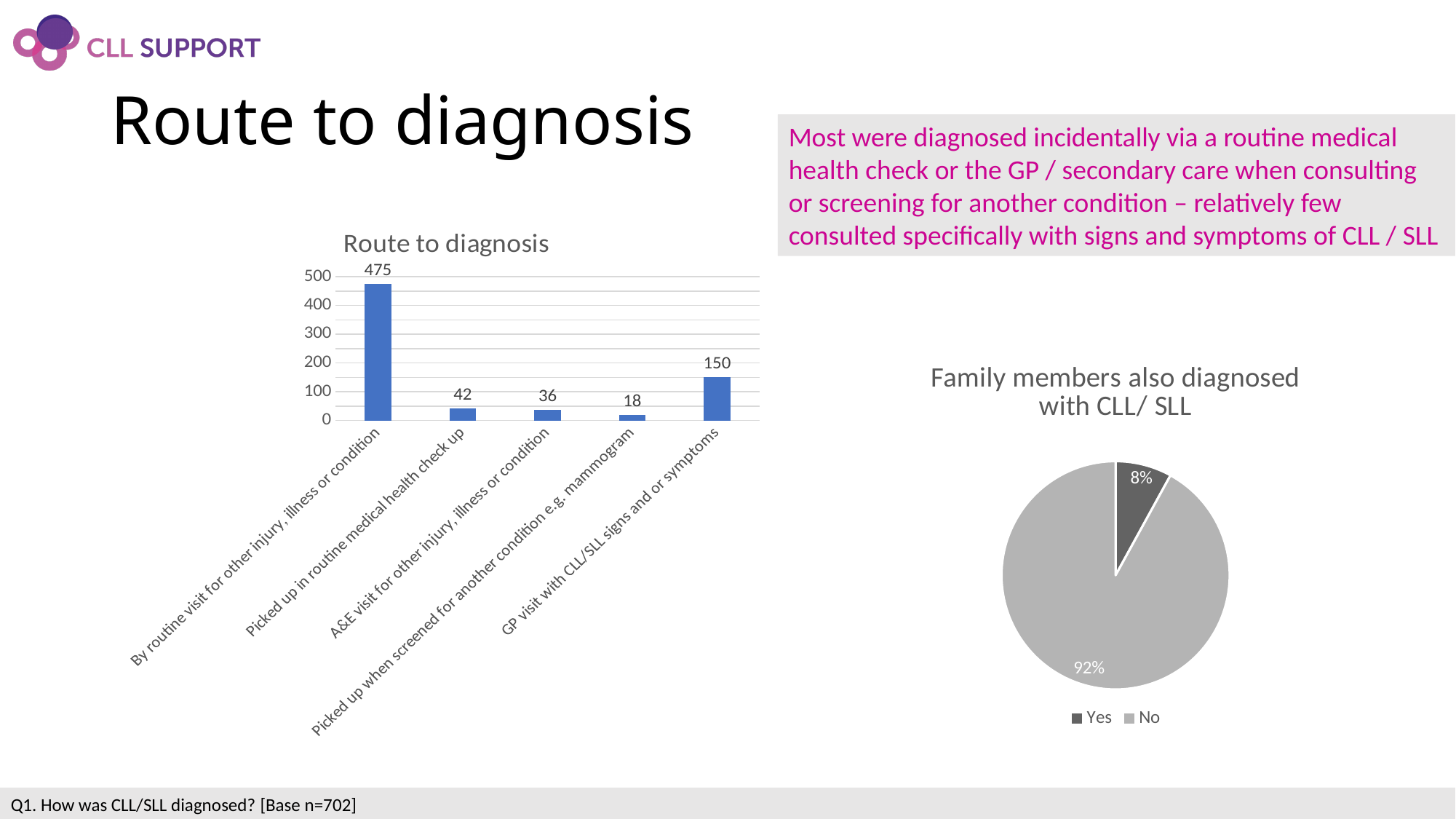
How many entries does the legend of the 'Family members also diagnosed with CLL/ SLL' chart list? 2 What kind of chart is the 'Route to diagnosis' chart? Bar chart In the 'Route to diagnosis' chart, what is the value for 'By routine visit for other injury, illness or condition'? 475 In the 'Route to diagnosis' chart, which category has the highest value? By routine visit for other injury, illness or condition In the 'Family members also diagnosed with CLL/ SLL' chart, what share of the pie is 'No'? 92% In the 'Route to diagnosis' chart, what is the value for 'GP visit with CLL/SLL signs and or symptoms'? 150 In the 'Route to diagnosis' chart, what is the value for 'Picked up when screened for another condition e.g. mammogram'? 18 In the 'Family members also diagnosed with CLL/ SLL' chart, what share of the pie is 'Yes'? 8% In the 'Route to diagnosis' chart, which is larger: 'Picked up in routine medical health check up' or 'A&E visit for other injury, illness or condition'? Picked up in routine medical health check up How many categories are shown in the 'Route to diagnosis' chart? 5 In the 'Route to diagnosis' chart, which category has the lowest value? Picked up when screened for another condition e.g. mammogram In the 'Route to diagnosis' chart, what is the difference between 'By routine visit for other injury, illness or condition' and 'GP visit with CLL/SLL signs and or symptoms'? 325